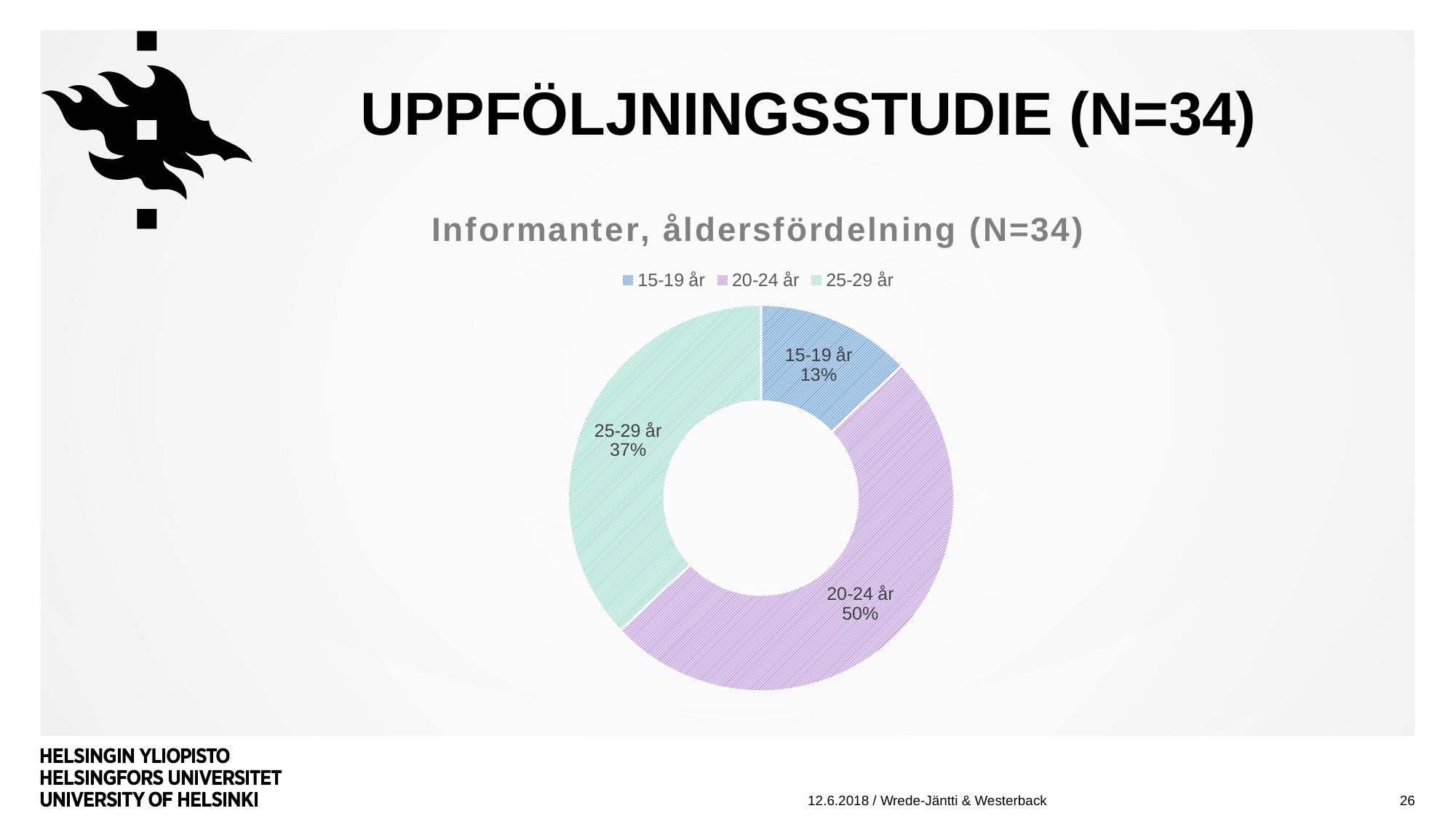
Which age group has the smallest share of informants? 15-19 år What is the title of the chart? Informanter, åldersfördelning (N=34) Which share is larger, 25-29 år or 15-19 år? 25-29 år What is the difference in percentage points between the 20-24 år and 15-19 år shares? 37 What share of the informants are in the 15-19 år age group? 13% What is the difference in percentage points between the 25-29 år and 15-19 år shares? 24 How many entries does the chart legend list? 3 What kind of chart is shown on the slide? Doughnut (pie) chart What share of the informants are in the 20-24 år age group? 50% Which age group has the largest share of informants? 20-24 år How many age groups are shown in the chart? 3 What share of the informants are in the 25-29 år age group? 37%